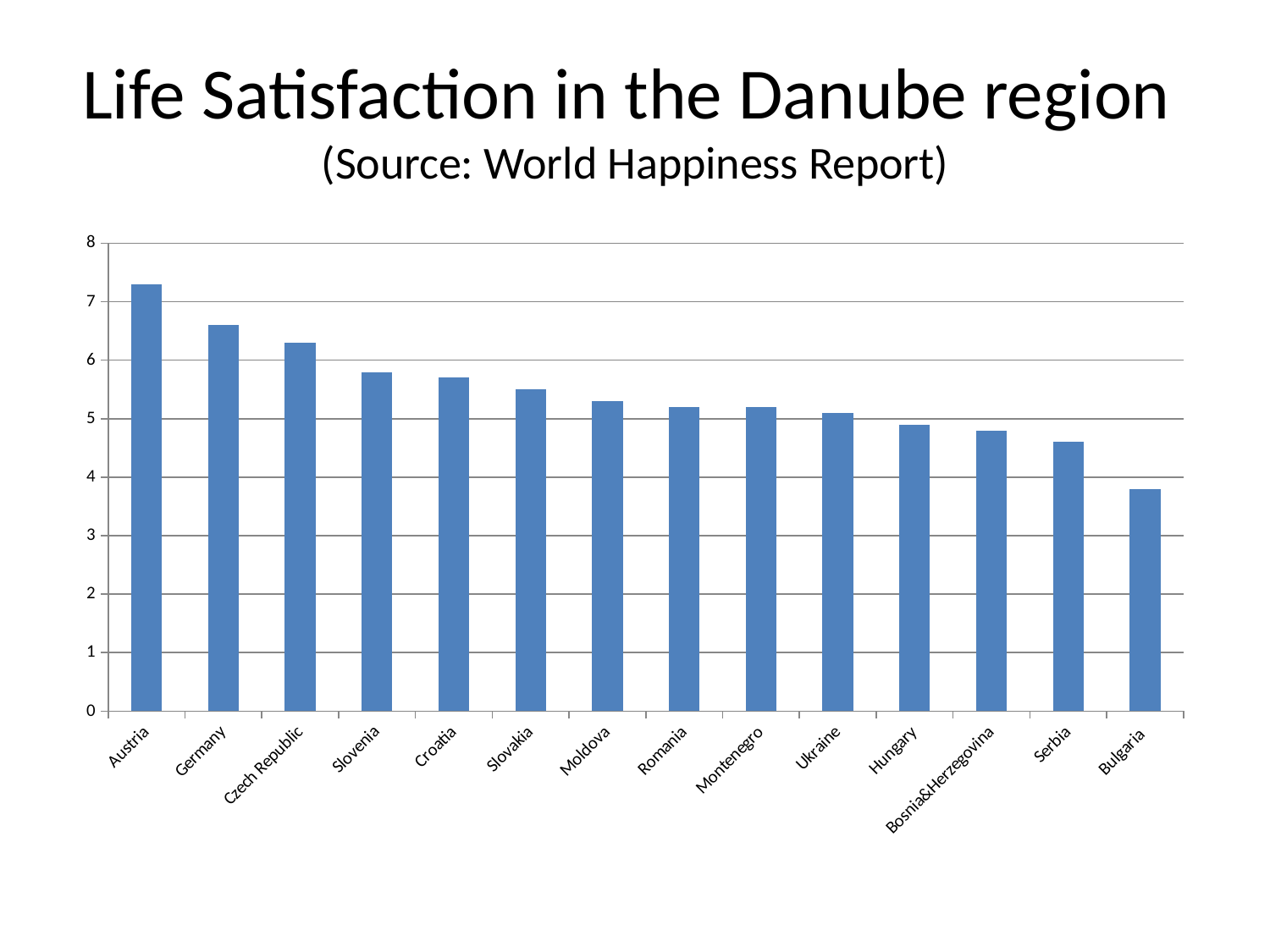
Is the value for Austria greater or less than 7? greater Is the value for Bulgaria greater or less than 4? less Is the value for Slovenia greater or less than 6? less Which country has the highest life satisfaction value? Austria What is the source of the data given in the chart title? World Happiness Report What kind of chart is shown on the slide? bar chart Do the values rise or fall from left to right along the x axis? fall Which country has the lowest life satisfaction value? Bulgaria How many countries are shown on the chart? 14 Which has the larger value, Austria or Germany? Austria